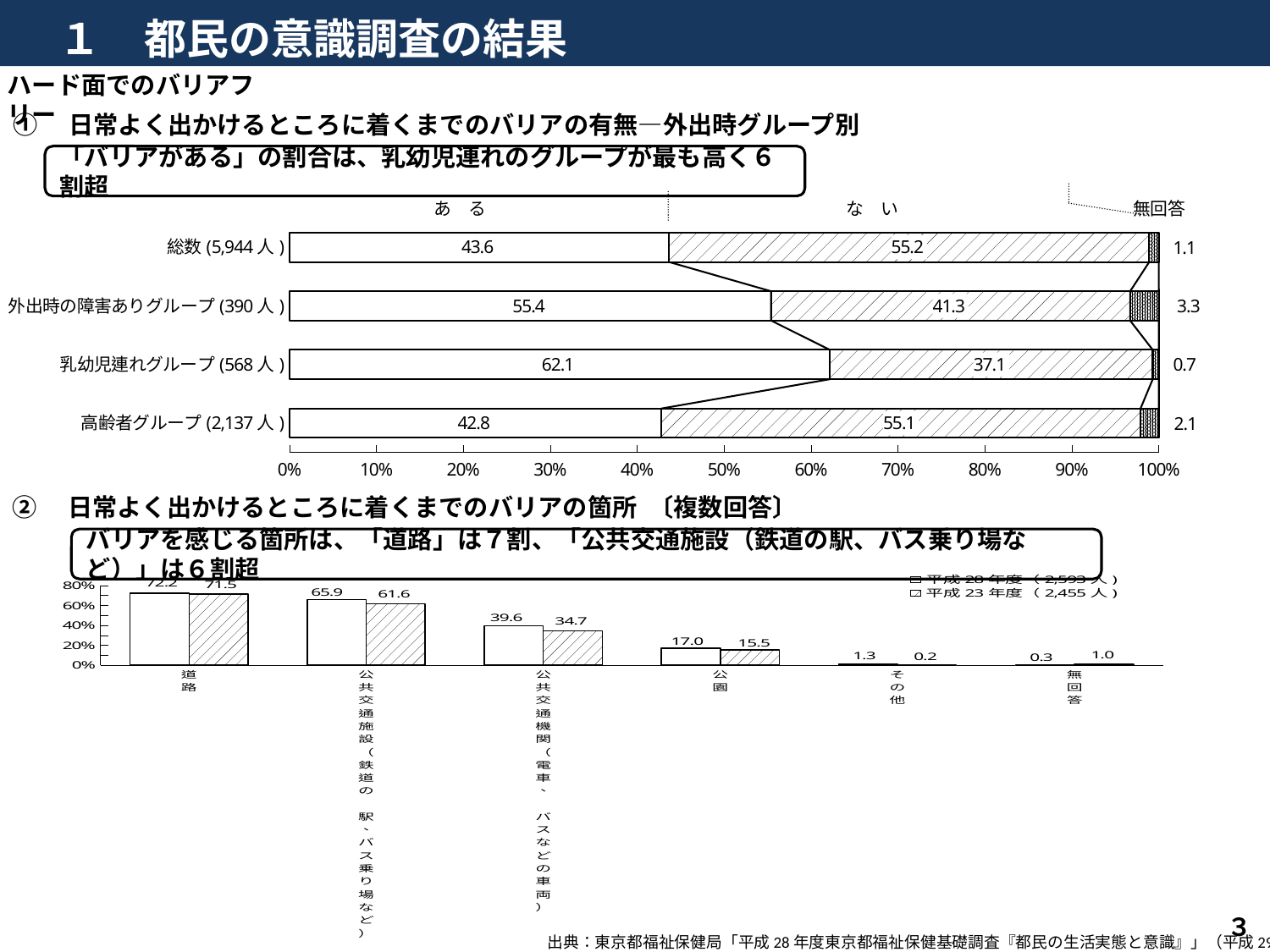
In the bottom chart, which is larger for 公園: the 平成28年度 value or the 平成23年度 value? 平成28年度 In the top chart, what is the difference between the 「ある」 values for 乳幼児連れグループ and 高齢者グループ? 19.3 In the bottom chart (日常よく出かけるところに着くまでのバリアの箇所), what is the 平成28年度 value for 道路? 72.2 What kind of chart is the bottom chart? bar chart In the top chart, what is the 「ない」 value for 総数? 55.2 In the top chart, which group has the highest 「ある」 value? 乳幼児連れグループ In the top chart, how many groups (bars) are shown? 4 In the top chart, what is the 無回答 value for 外出時の障害ありグループ? 3.3 In the bottom chart, how many series does the legend list? 2 In the top chart (日常よく出かけるところに着くまでのバリアの有無), what is the 「ある」 value for 乳幼児連れグループ? 62.1 In the top chart, which group has the lowest 「ある」 value? 高齢者グループ In the bottom chart, what is the 平成23年度 value for 公共交通施設? 61.6